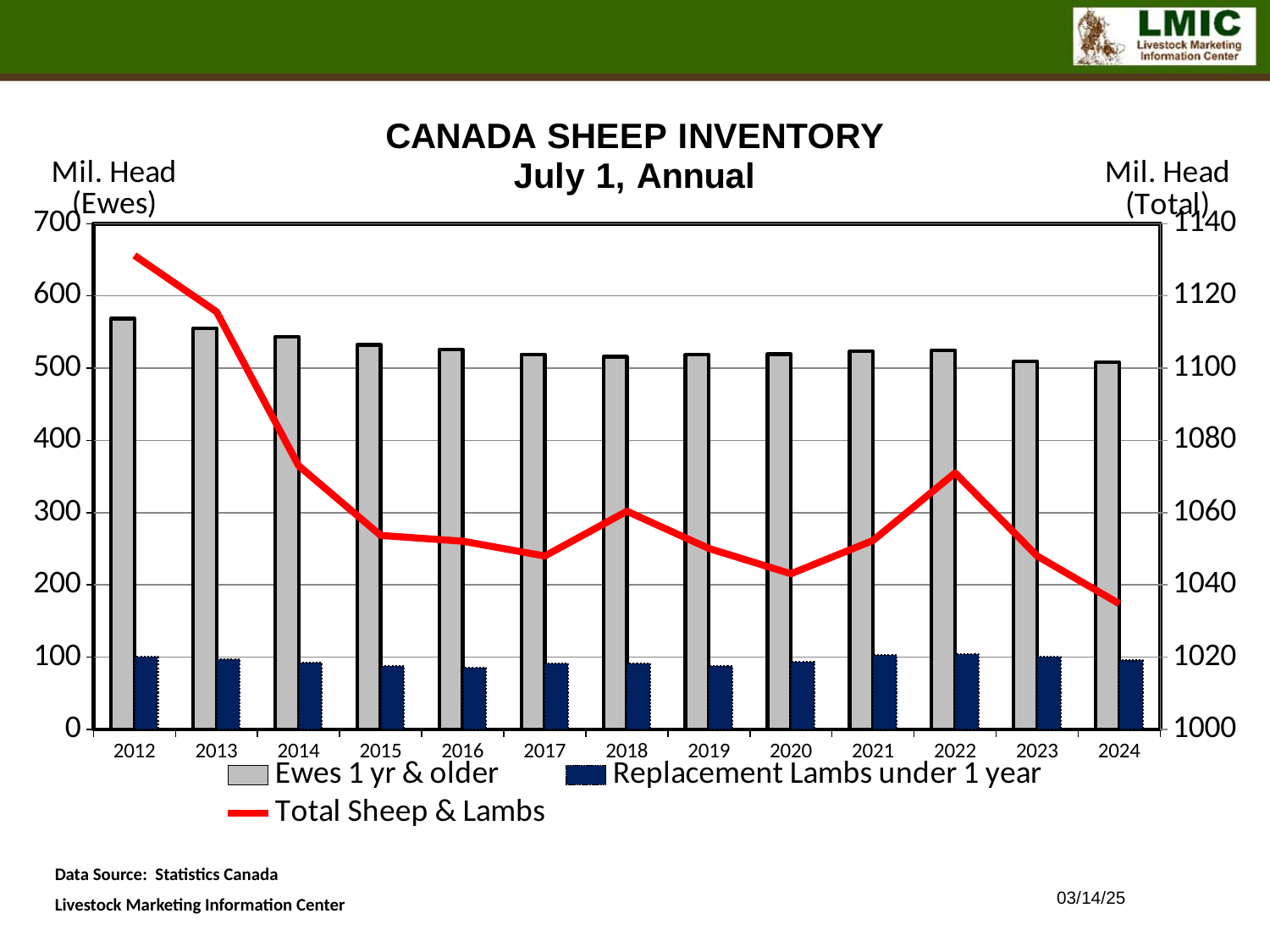
Which year has the highest value for Total Sheep & Lambs? 2012 What kind of chart is this? Combination bar and line chart How many years are shown on the x axis? 13 How many series does the legend list? 3 Is the value for Total Sheep & Lambs in 2024 greater or less than 1040? less What is the title of the chart? CANADA SHEEP INVENTORY July 1, Annual Which year has the lowest value for Total Sheep & Lambs? 2024 Which year has the highest value for Ewes 1 yr & older? 2012 Does the Total Sheep & Lambs line generally rise or fall from 2012 to 2024? fall Is the value for Total Sheep & Lambs in 2022 greater or less than 1060? greater Is the value for Ewes 1 yr & older in 2012 greater or less than 500? greater Which is larger, Total Sheep & Lambs in 2018 or in 2020? 2018